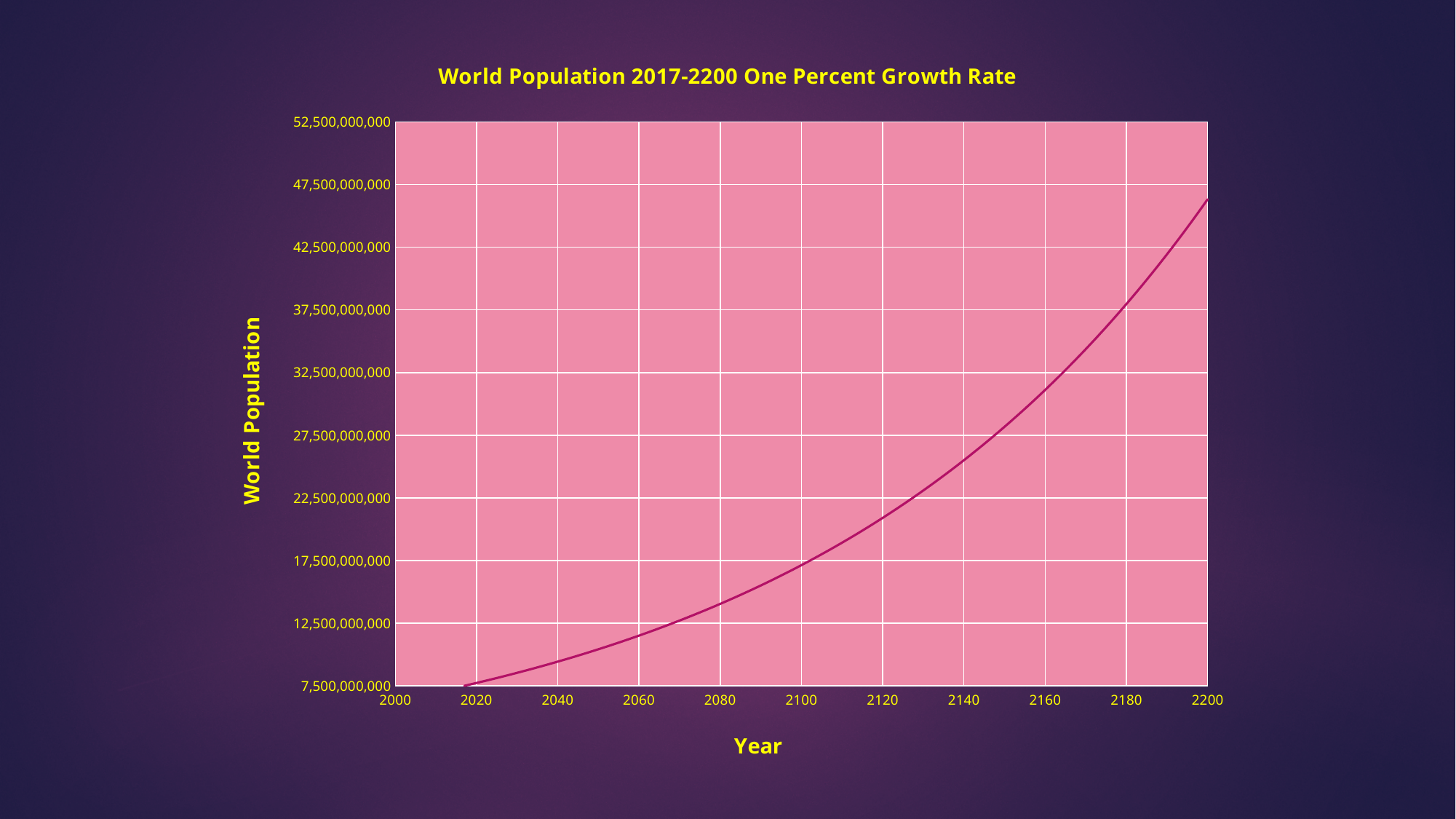
What is the label of the vertical axis? World Population Which year has the larger world population value, 2120 or 2160? 2160 In which year shown on the x axis does the line reach its highest value? 2200 Does the world population rise or fall as the year increases along the x axis? Rise What kind of chart is shown on the slide? Line chart Is the world population value for 2140 greater or less than 22,500,000,000? greater What is the title of the chart? World Population 2017-2200 One Percent Growth Rate Is the world population value for 2040 greater or less than 12,500,000,000? less Is the world population value for 2180 greater or less than 32,500,000,000? greater